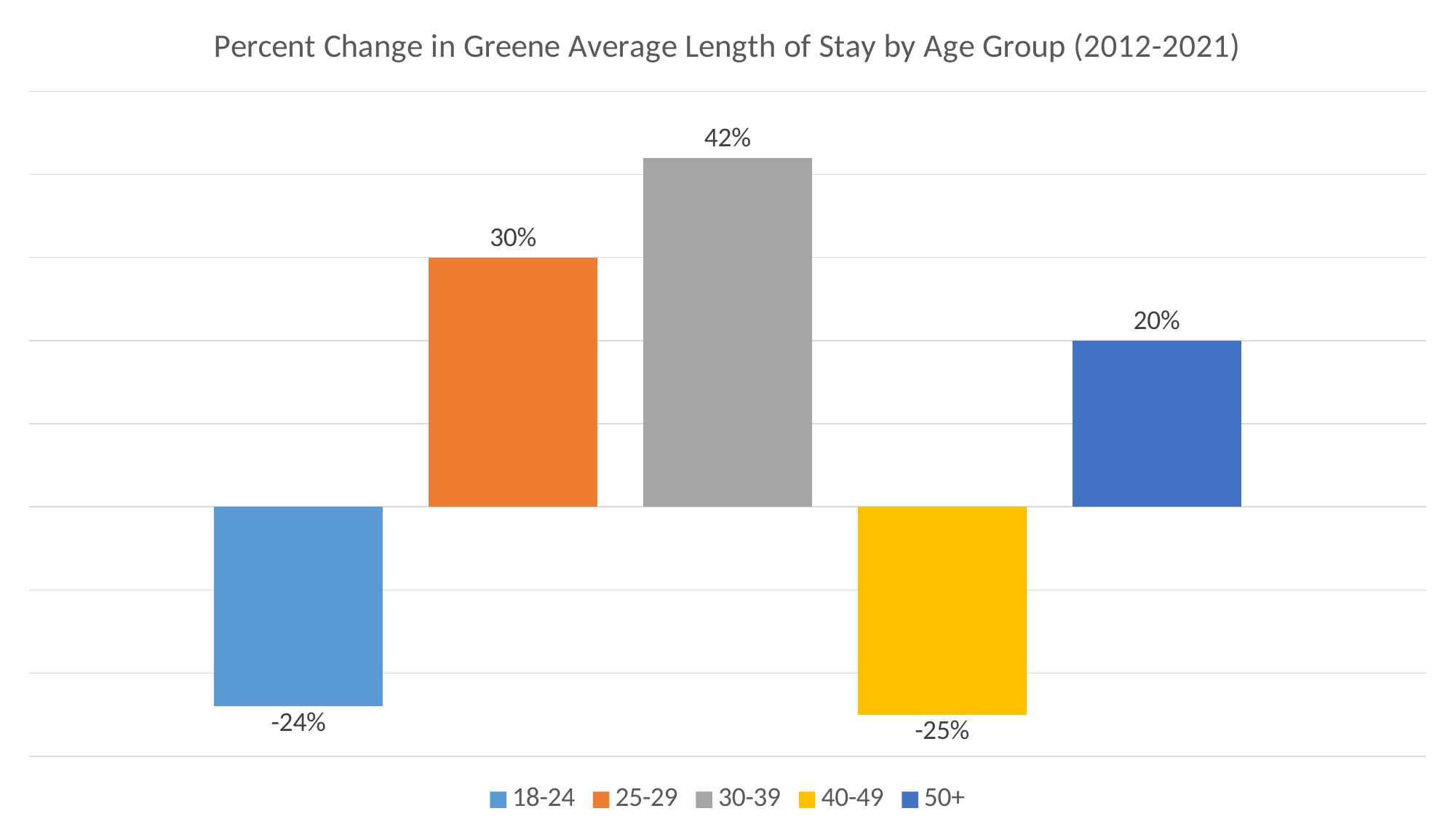
What is the percent change in average length of stay for the 18-24 age group? -24% How many entries does the legend list? 5 What type of chart is shown on the slide? Bar chart Which age group has the highest percent change in average length of stay? 30-39 What is the percent change in average length of stay for the 30-39 age group? 42% Which age group has a larger percent change, 25-29 or 50+? 25-29 What is the difference between the percent change for the 30-39 age group and the 25-29 age group? 12% Which age group has the lowest percent change in average length of stay? 40-49 What is the percent change in average length of stay for the 50+ age group? 20% What is the percent change in average length of stay for the 40-49 age group? -25% How many age groups are shown in the chart? 5 What is the title of the chart? Percent Change in Greene Average Length of Stay by Age Group (2012-2021)